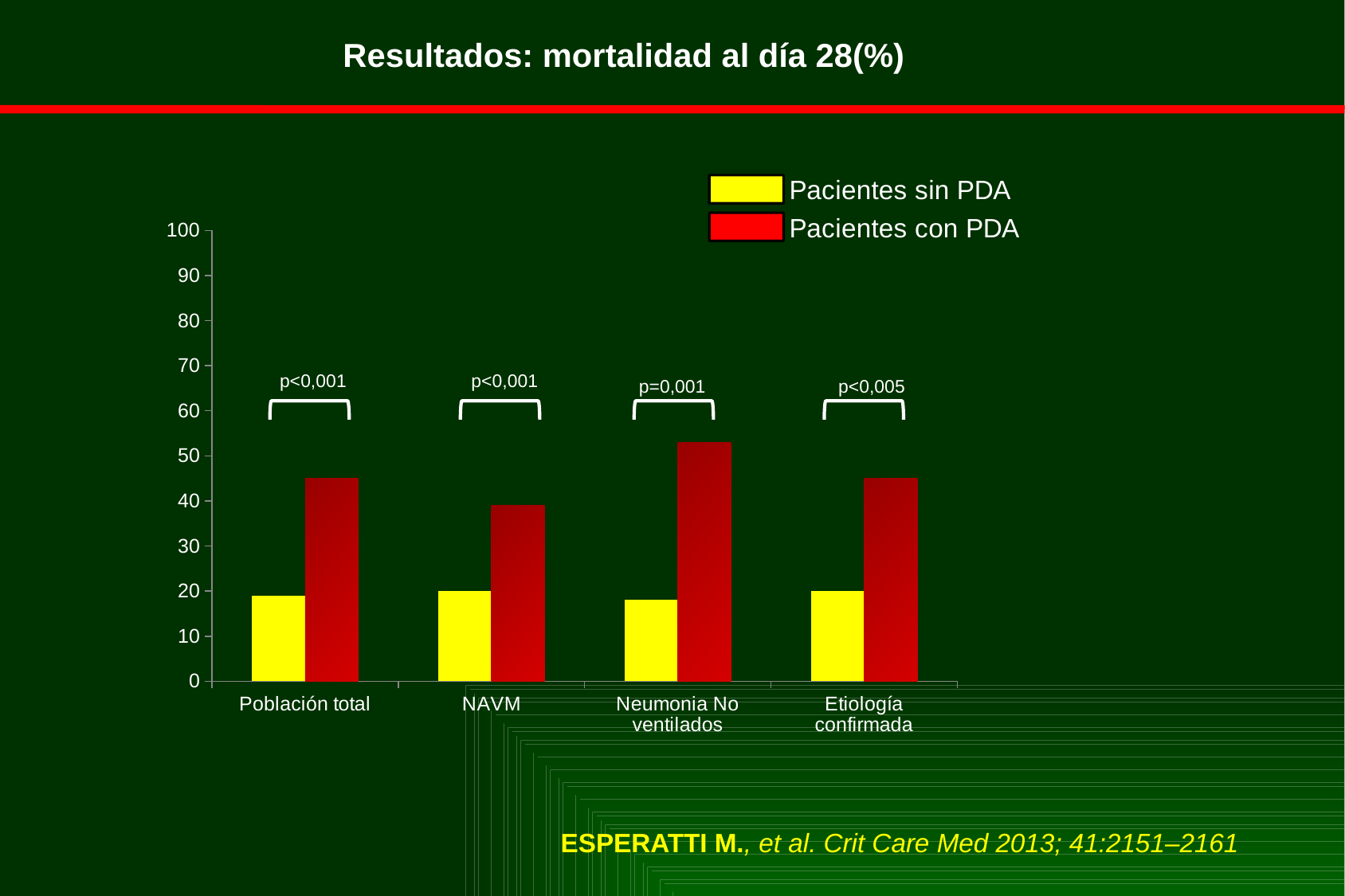
For Población total, which is larger: Pacientes sin PDA or Pacientes con PDA? Pacientes con PDA Which category has the highest value for Pacientes con PDA? Neumonia No ventilados Is the value for Pacientes sin PDA in Población total greater or less than 30? less Is the value for Pacientes con PDA in NAVM greater or less than 30? greater Is the value for Pacientes con PDA in Neumonia No ventilados greater or less than 50? greater Which category has the lowest value for Pacientes con PDA? NAVM What is the title of the chart? Resultados: mortalidad al día 28(%) What colour represents Pacientes sin PDA in the legend? yellow How many categories are shown on the x axis? 4 How many series does the legend list? 2 What kind of chart is shown on the slide? bar chart